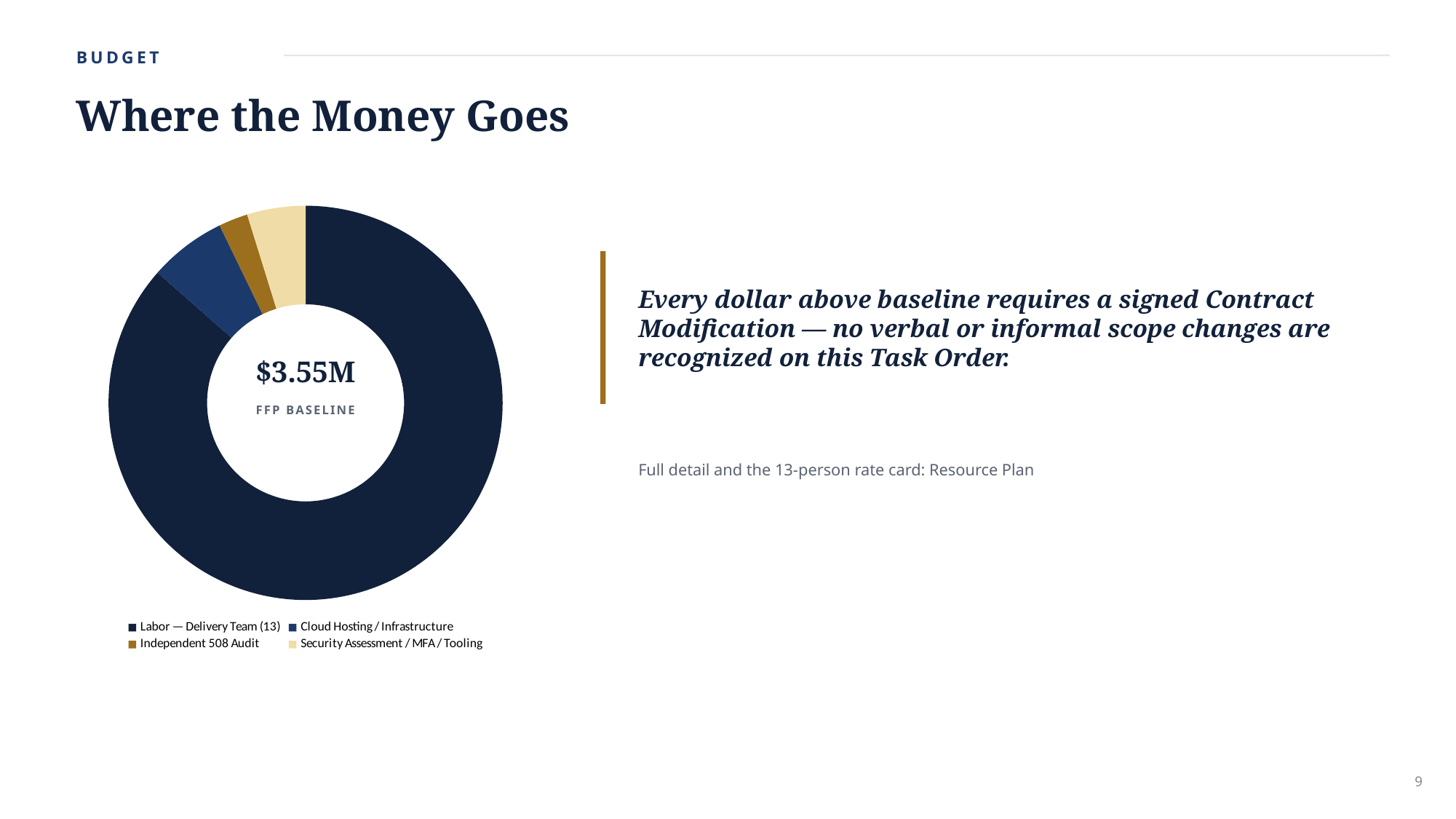
Which is larger: Security Assessment / MFA / Tooling or Independent 508 Audit? Security Assessment / MFA / Tooling Which is larger: Labor — Delivery Team (13) or Cloud Hosting / Infrastructure? Labor — Delivery Team (13) Which category takes the largest share of the donut chart? Labor — Delivery Team (13) What kind of chart is shown on the slide? Pie chart (donut) Which is larger: Cloud Hosting / Infrastructure or Independent 508 Audit? Cloud Hosting / Infrastructure How many categories does the donut chart show? 4 What total value is printed in the center of the donut chart? $3.55M Which category takes the smallest share of the donut chart? Independent 508 Audit What label appears beneath the value in the center of the donut chart? FFP BASELINE Which category is shown in the light yellow colour in the donut chart? Security Assessment / MFA / Tooling